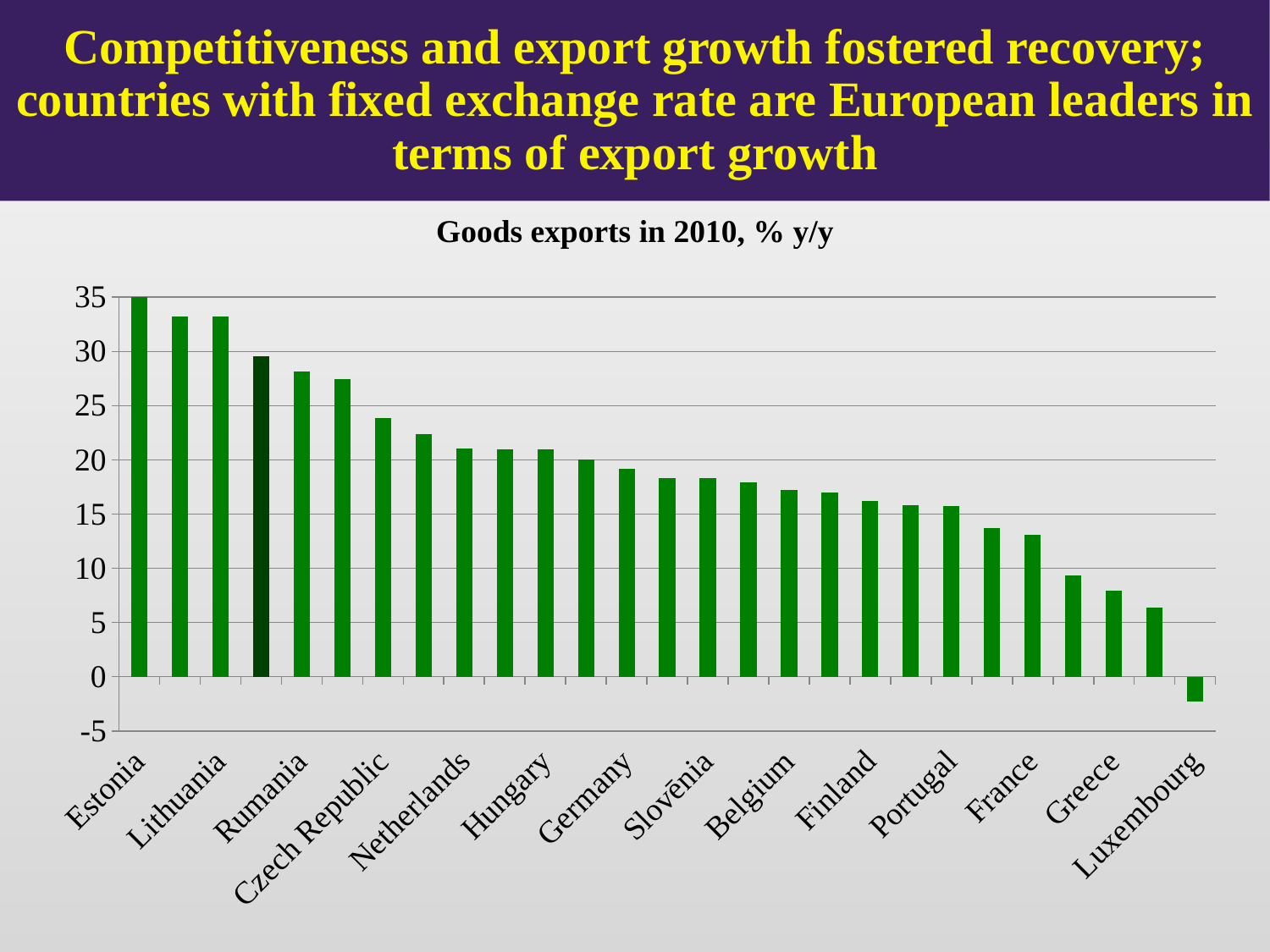
Is the value for Greece greater or less than 10? less Is the value for Estonia greater or less than 30? greater Do the values rise or fall moving from left to right along the x axis? fall Is the value for Germany greater or less than 15? greater What is the title of the chart? Goods exports in 2010, % y/y How many bars are plotted in the chart? 27 Which country has the highest goods export growth in the chart? Estonia Which has the larger value, Lithuania or Greece? Lithuania What kind of chart is shown on the slide? bar chart Which country has the lowest goods export growth in the chart? Luxembourg